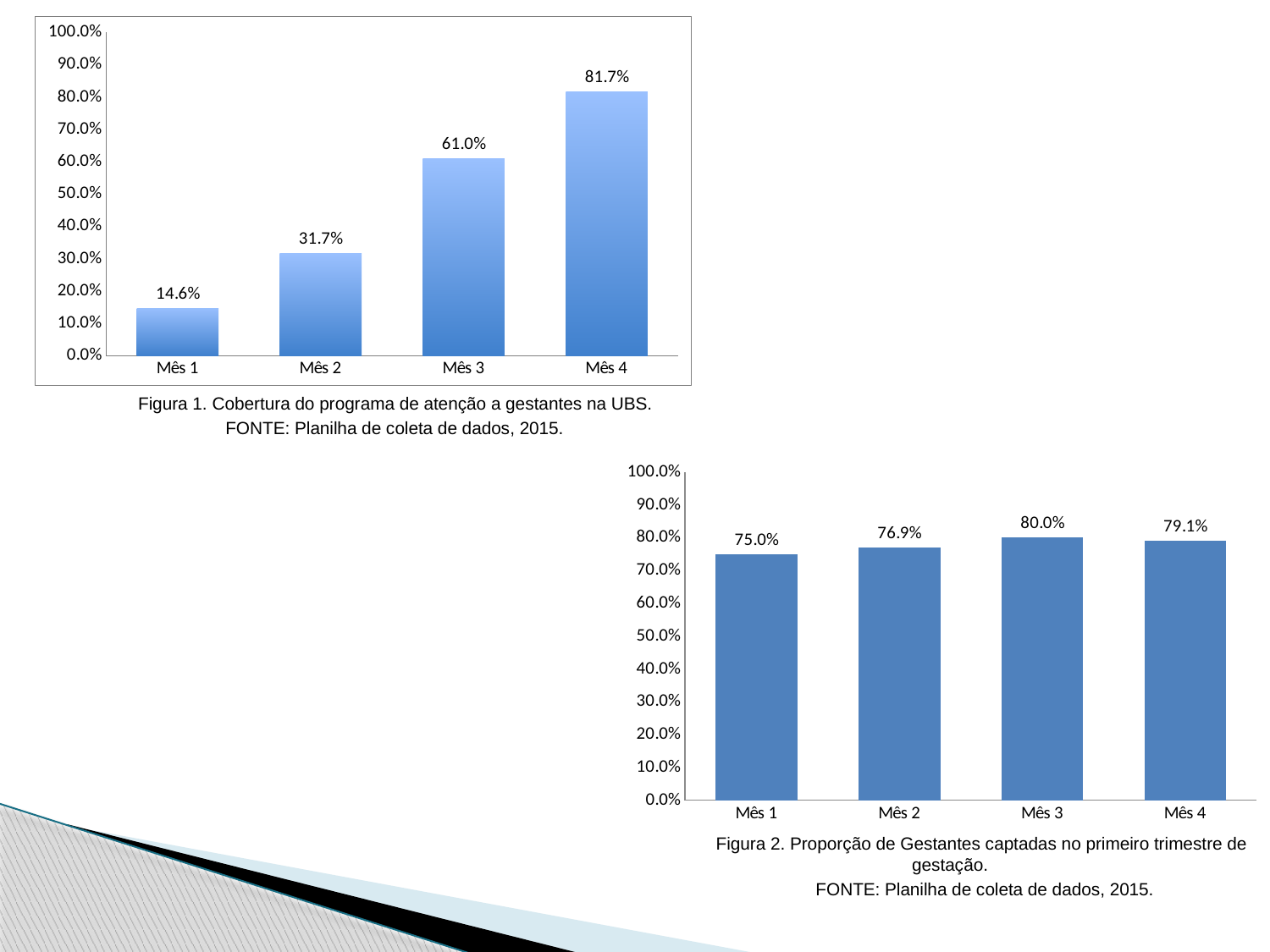
In Figura 1 (Cobertura do programa de atenção a gestantes na UBS), do the values rise or fall from Mês 1 to Mês 4? rise In Figura 2 (Proporção de Gestantes captadas no primeiro trimestre de gestação), which month has the highest value? Mês 3 In Figura 2 (Proporção de Gestantes captadas no primeiro trimestre de gestação), which month has the lowest value? Mês 1 Which is larger: the value for Mês 4 in Figura 1 or the value for Mês 4 in Figura 2? Mês 4 in Figura 1 In Figura 2 (Proporção de Gestantes captadas no primeiro trimestre de gestação), what is the value for Mês 2? 76.9% In Figura 2 (Proporção de Gestantes captadas no primeiro trimestre de gestação), what kind of chart is shown? bar chart In Figura 1 (Cobertura do programa de atenção a gestantes na UBS), how many months are plotted? 4 In Figura 2 (Proporção de Gestantes captadas no primeiro trimestre de gestação), what is the difference between the values for Mês 3 and Mês 1? 5.0% In Figura 1 (Cobertura do programa de atenção a gestantes na UBS), which month has the highest value? Mês 4 In Figura 1 (Cobertura do programa de atenção a gestantes na UBS), which month has the lowest value? Mês 1 In Figura 1 (Cobertura do programa de atenção a gestantes na UBS), what is the value for Mês 3? 61.0% In Figura 1 (Cobertura do programa de atenção a gestantes na UBS), what is the difference between the values for Mês 4 and Mês 1? 67.1%